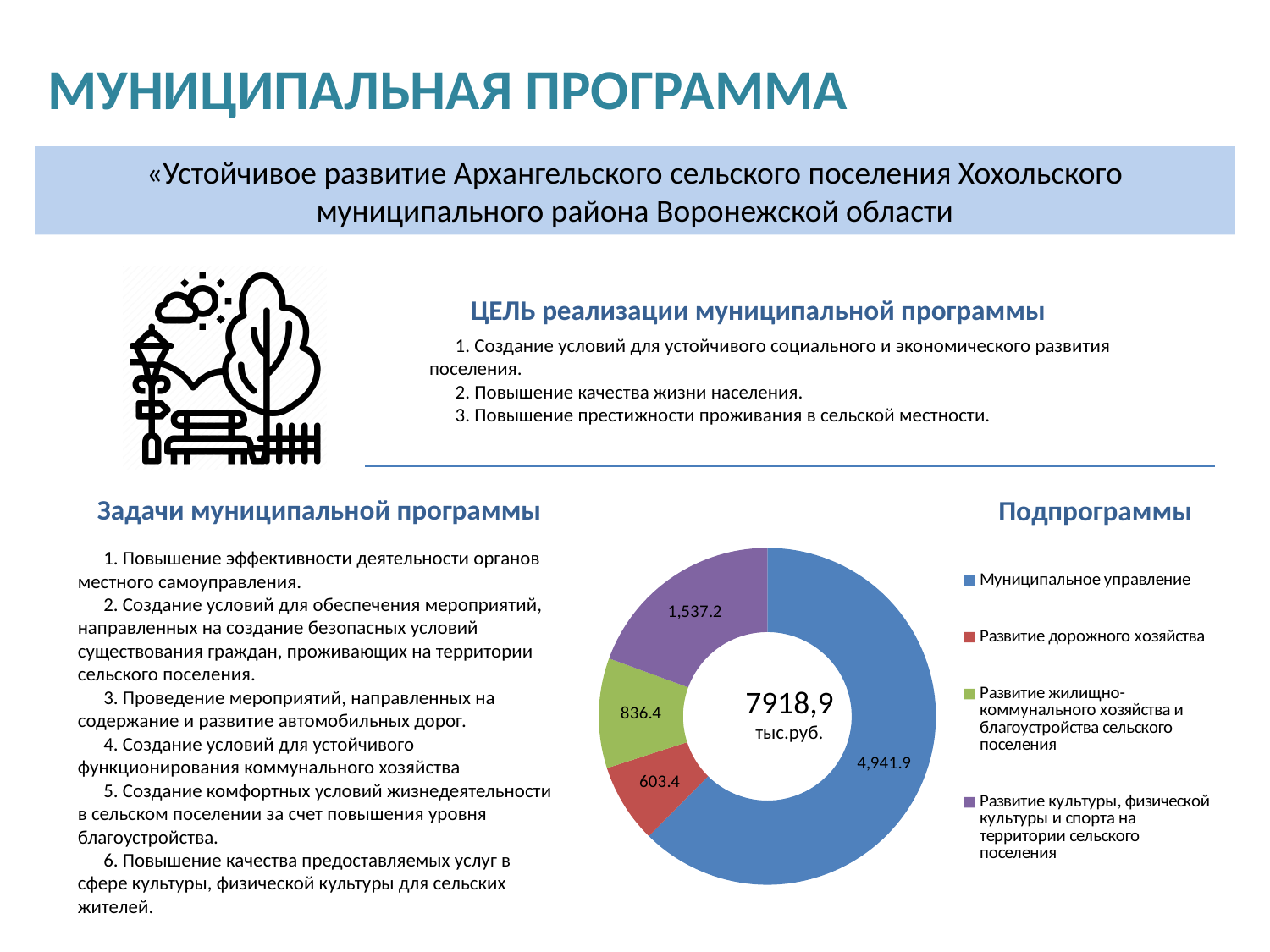
How many slices does the Подпрограммы chart have? 4 Which subprogram has the smallest value in the Подпрограммы chart? Развитие дорожного хозяйства What is the value for Развитие культуры, физической культуры и спорта на территории сельского поселения in the Подпрограммы chart? 1,537.2 What colour is the slice for Развитие дорожного хозяйства in the Подпрограммы chart? Red In the Подпрограммы chart, what is the difference between the values for Муниципальное управление and Развитие культуры, физической культуры и спорта на территории сельского поселения? 3,404.7 What is the value for Муниципальное управление in the Подпрограммы chart? 4,941.9 Which subprogram has the largest value in the Подпрограммы chart? Муниципальное управление What is the value for Развитие жилищно-коммунального хозяйства и благоустройства сельского поселения in the Подпрограммы chart? 836.4 What type of chart is shown under Подпрограммы? Doughnut chart What total value is shown in the centre of the Подпрограммы chart? 7918,9 тыс.руб. What is the value for Развитие дорожного хозяйства in the Подпрограммы chart? 603.4 In the Подпрограммы chart, which is larger: Развитие жилищно-коммунального хозяйства и благоустройства сельского поселения or Развитие дорожного хозяйства? Развитие жилищно-коммунального хозяйства и благоустройства сельского поселения